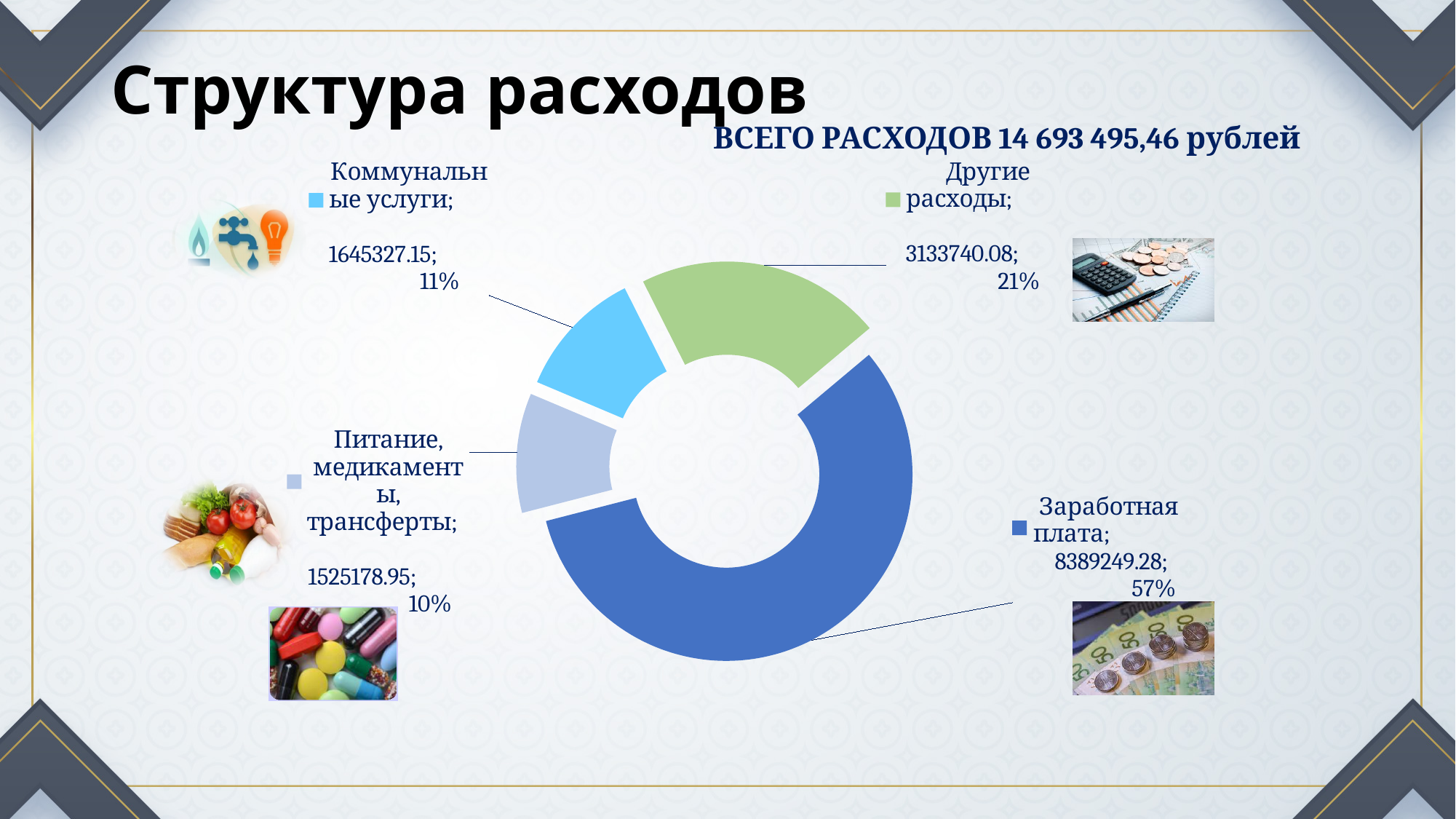
Which is larger, Другие расходы or Коммунальные услуги? Другие расходы What is the difference between the values for Коммунальные услуги and Питание, медикаменты, трансферты? 120148.20 What is the value for Заработная плата? 8389249.28 How many categories does the chart show? 4 What share of the chart does Другие расходы represent? 21% What share of the chart does Питание, медикаменты, трансферты represent? 10% What total expenditure is stated above the chart? 14 693 495,46 рублей What is the difference in percentage points between Заработная плата and Другие расходы? 36 percentage points Which category has the smallest share of the chart? Питание, медикаменты, трансферты What kind of chart is shown on the slide? Doughnut (pie) chart What is the value for Коммунальные услуги? 1645327.15 Which category has the largest share of the chart? Заработная плата